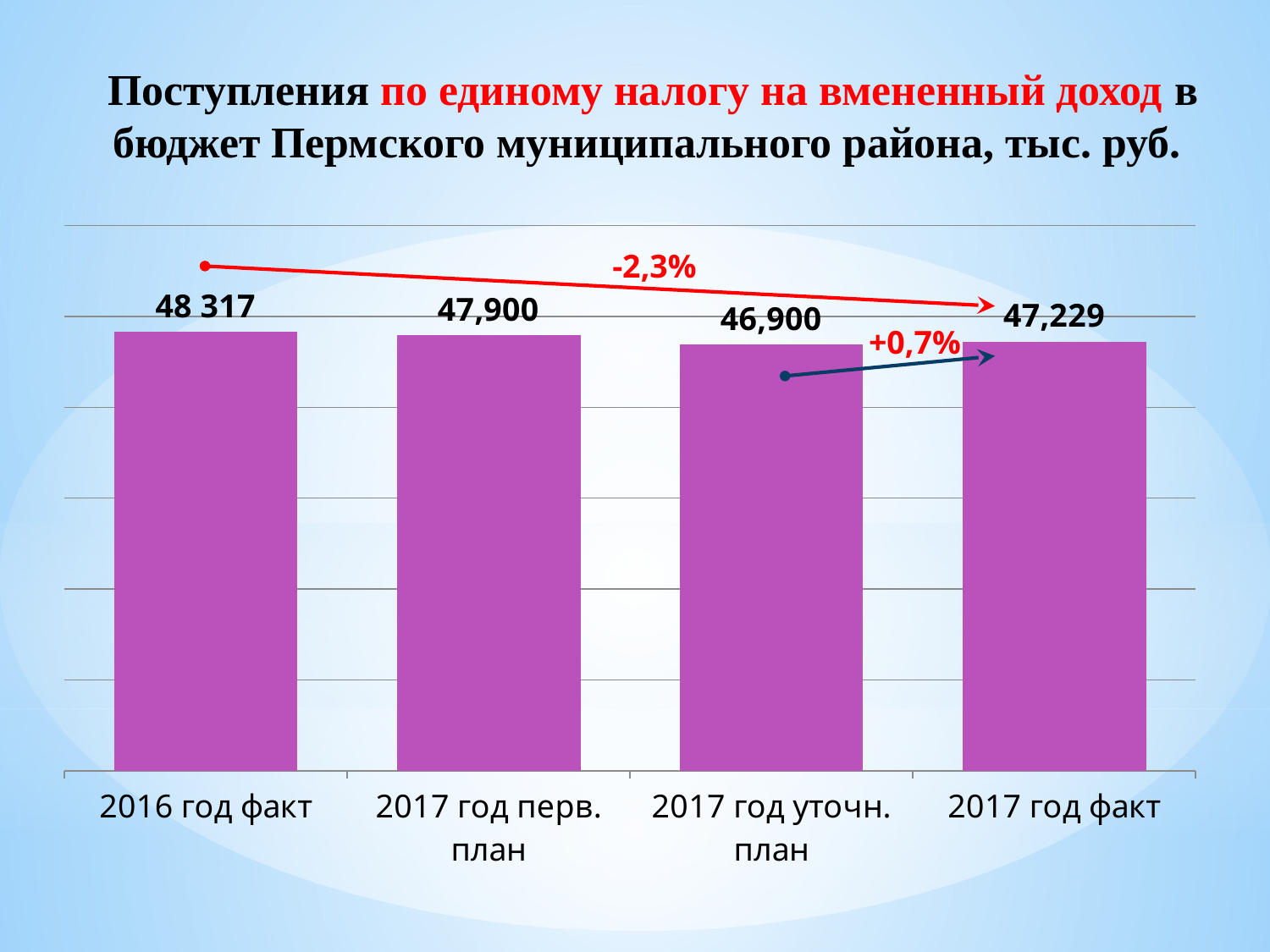
What is the difference between 2017 год перв. план and 2017 год уточн. план? 1,000 What is the difference between 2017 год факт and 2017 год уточн. план? 329 Which is larger, 2017 год факт or 2017 год перв. план? 2017 год перв. план What is the value for 2017 год уточн. план? 46,900 What is the value for 2016 год факт? 48 317 What kind of chart is this? bar chart What is the value for 2017 год перв. план? 47,900 Which category has the highest value? 2016 год факт Which category has the lowest value? 2017 год уточн. план What percentage change is shown by the red arrow from 2016 год факт to 2017 год факт? -2,3% How many categories are shown on the x axis? 4 What is the value for 2017 год факт? 47,229